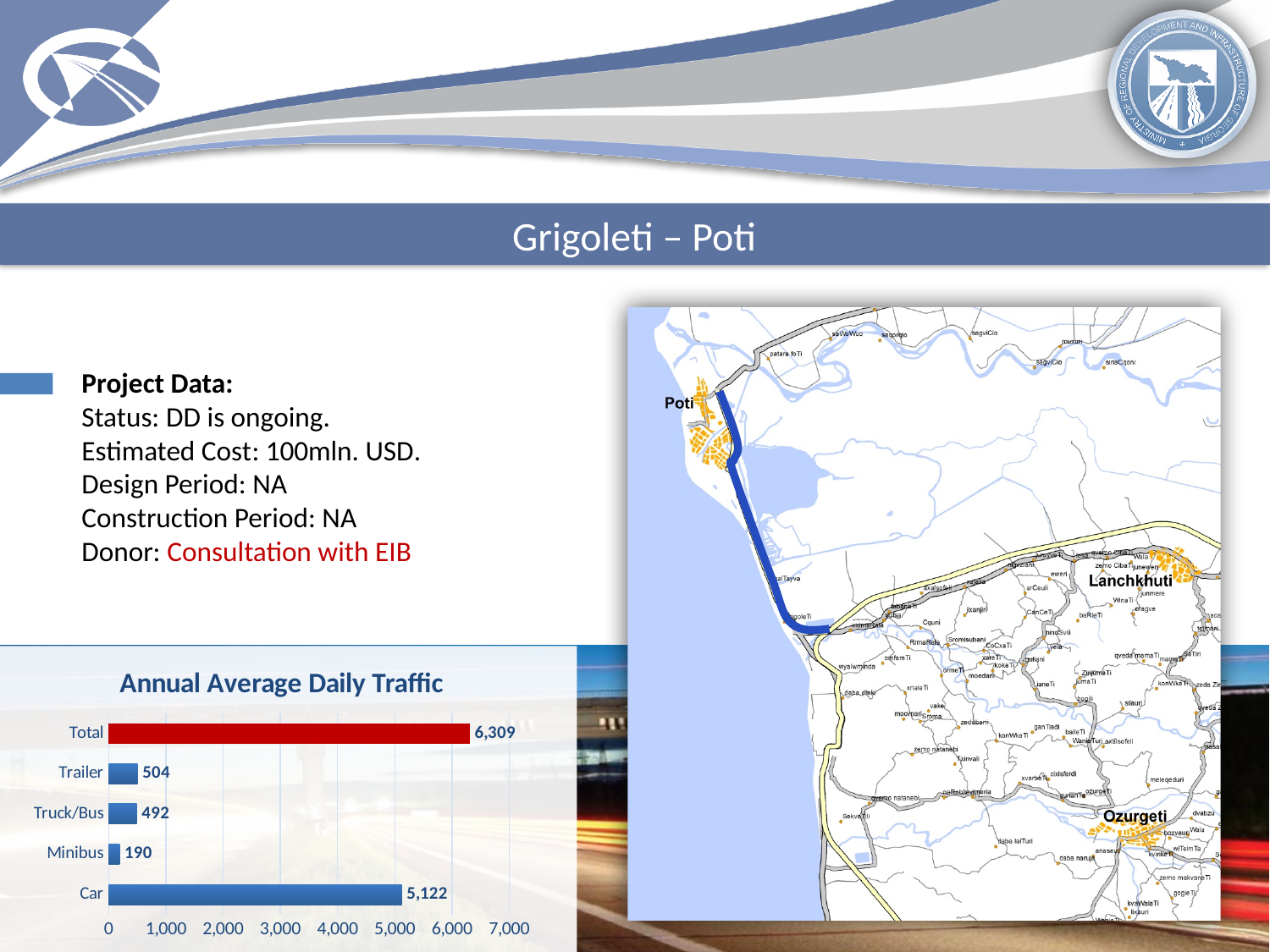
What is the value for Car in the Annual Average Daily Traffic chart? 5,122 What is the value for Total in the Annual Average Daily Traffic chart? 6,309 Excluding Total, which category has the highest value in the Annual Average Daily Traffic chart? Car What is the value for Minibus in the Annual Average Daily Traffic chart? 190 What is the value for Truck/Bus in the Annual Average Daily Traffic chart? 492 What kind of chart is the Annual Average Daily Traffic chart? Bar chart What is the difference between the Car and Minibus values in the Annual Average Daily Traffic chart? 4,932 Which category has the lowest value in the Annual Average Daily Traffic chart? Minibus What is the value for Trailer in the Annual Average Daily Traffic chart? 504 How many categories are shown in the Annual Average Daily Traffic chart? 5 What is the difference between the Trailer and Truck/Bus values in the Annual Average Daily Traffic chart? 12 Which is larger in the Annual Average Daily Traffic chart, Car or Trailer? Car